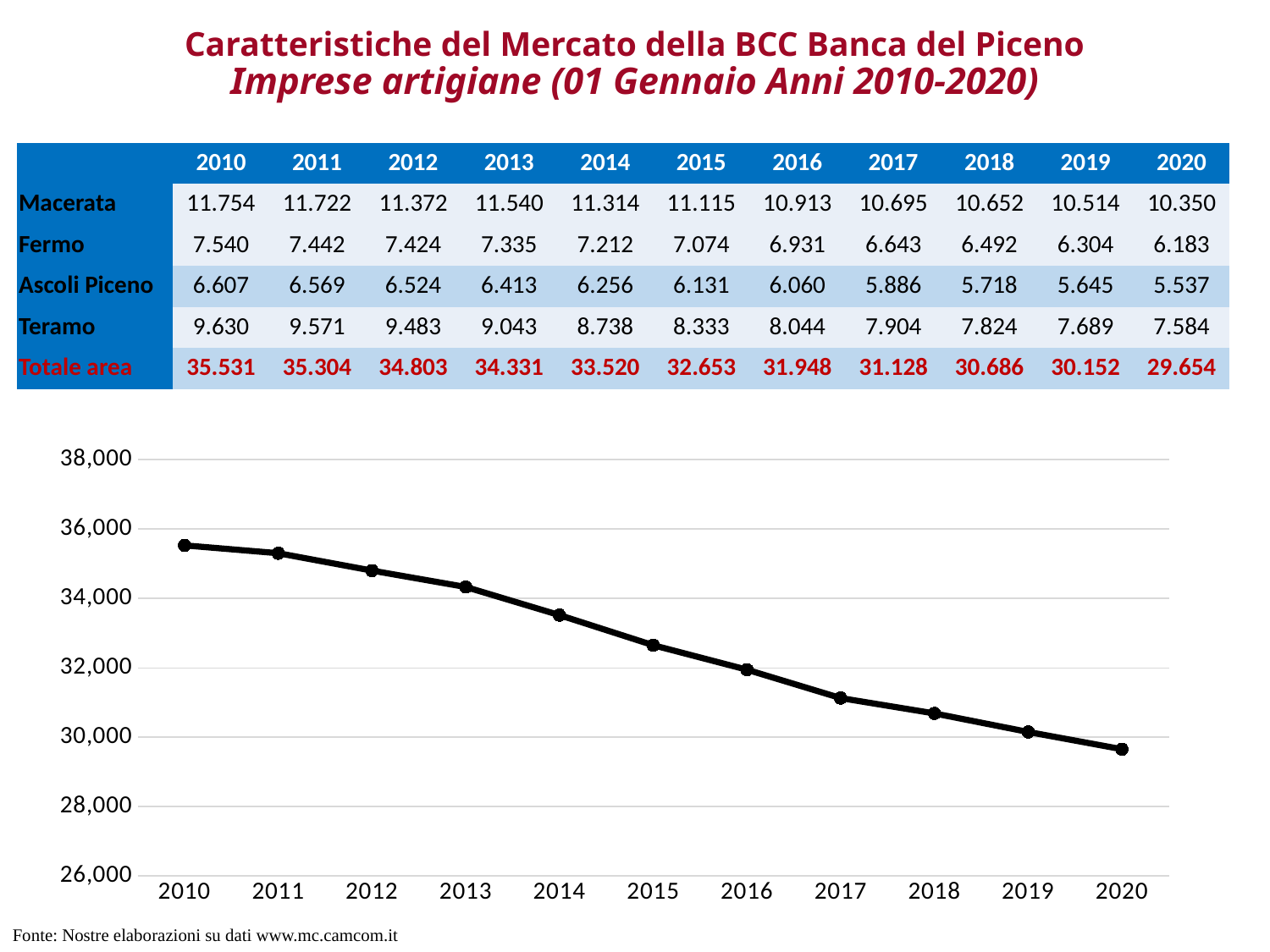
Do the values on the line chart rise or fall from 2010 to 2020? fall How many data points are plotted on the line chart? 11 Is the plotted value for 2012 greater or less than 34,000? greater Is the plotted value for 2017 greater or less than 30,000? greater Which year has the larger plotted value, 2013 or 2016? 2013 According to the table, what is the Totale area value for 2010, the first point on the line chart? 35.531 Which year has the highest value on the line chart? 2010 Is the plotted value for 2020 greater or less than 30,000? less What kind of chart is shown on the slide? line chart According to the table, what is the Totale area value for 2020, the last point on the line chart? 29.654 Which year has the lowest value on the line chart? 2020